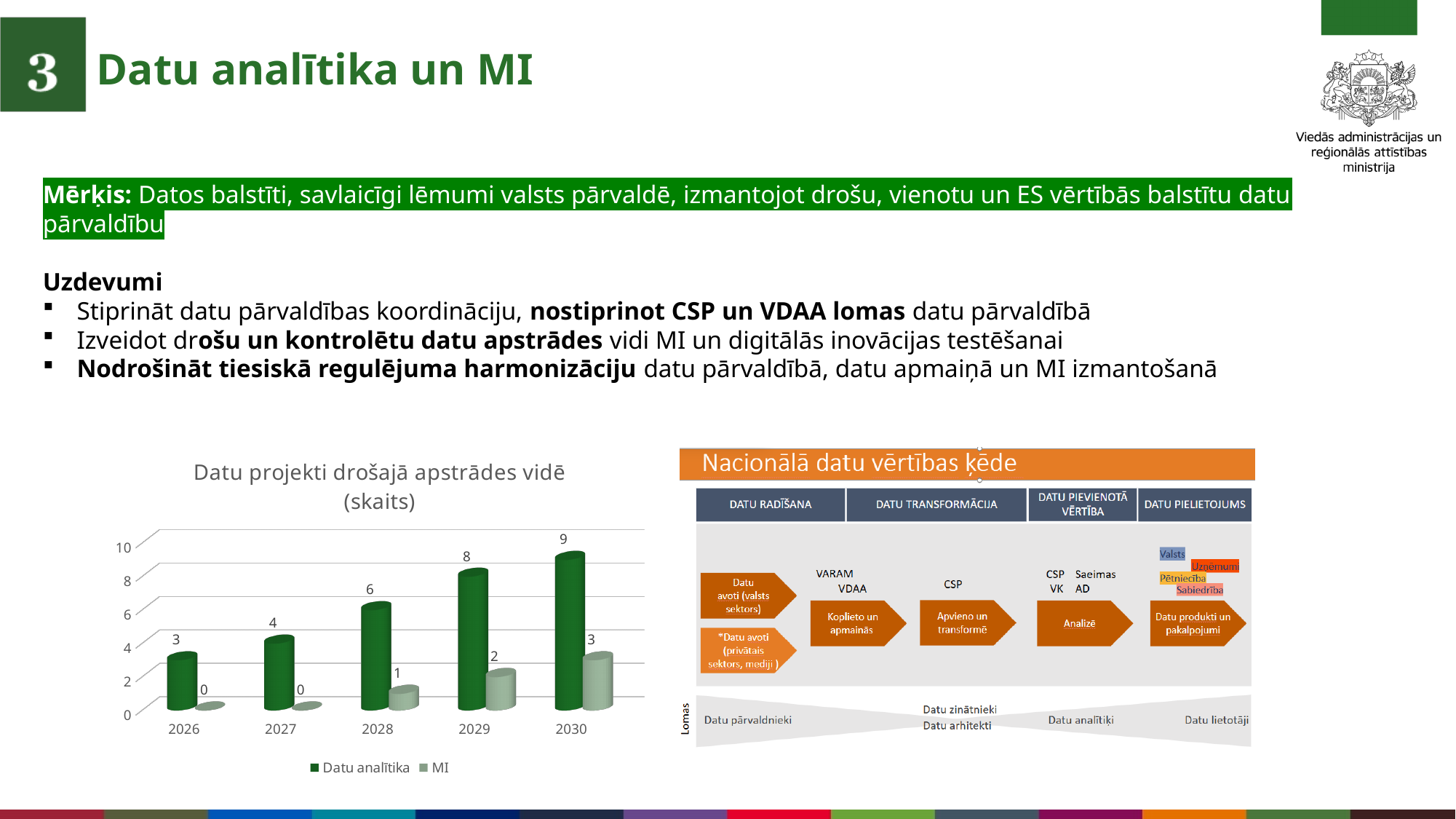
What kind of chart is shown? bar chart What is the difference between Datu analītika and MI in 2030? 6 What is the value for MI in 2029? 2 How many series does the legend list? 2 Which year has the highest value for Datu analītika? 2030 Do the values for Datu analītika rise or fall from 2026 to 2030? rise Which year has the lowest value for Datu analītika? 2026 What is the title of the chart? Datu projekti drošajā apstrādes vidē (skaits) What is the value for Datu analītika in 2026? 3 What is the value for Datu analītika in 2028? 6 How many years are shown on the x axis? 5 Which is larger in 2029, Datu analītika or MI? Datu analītika